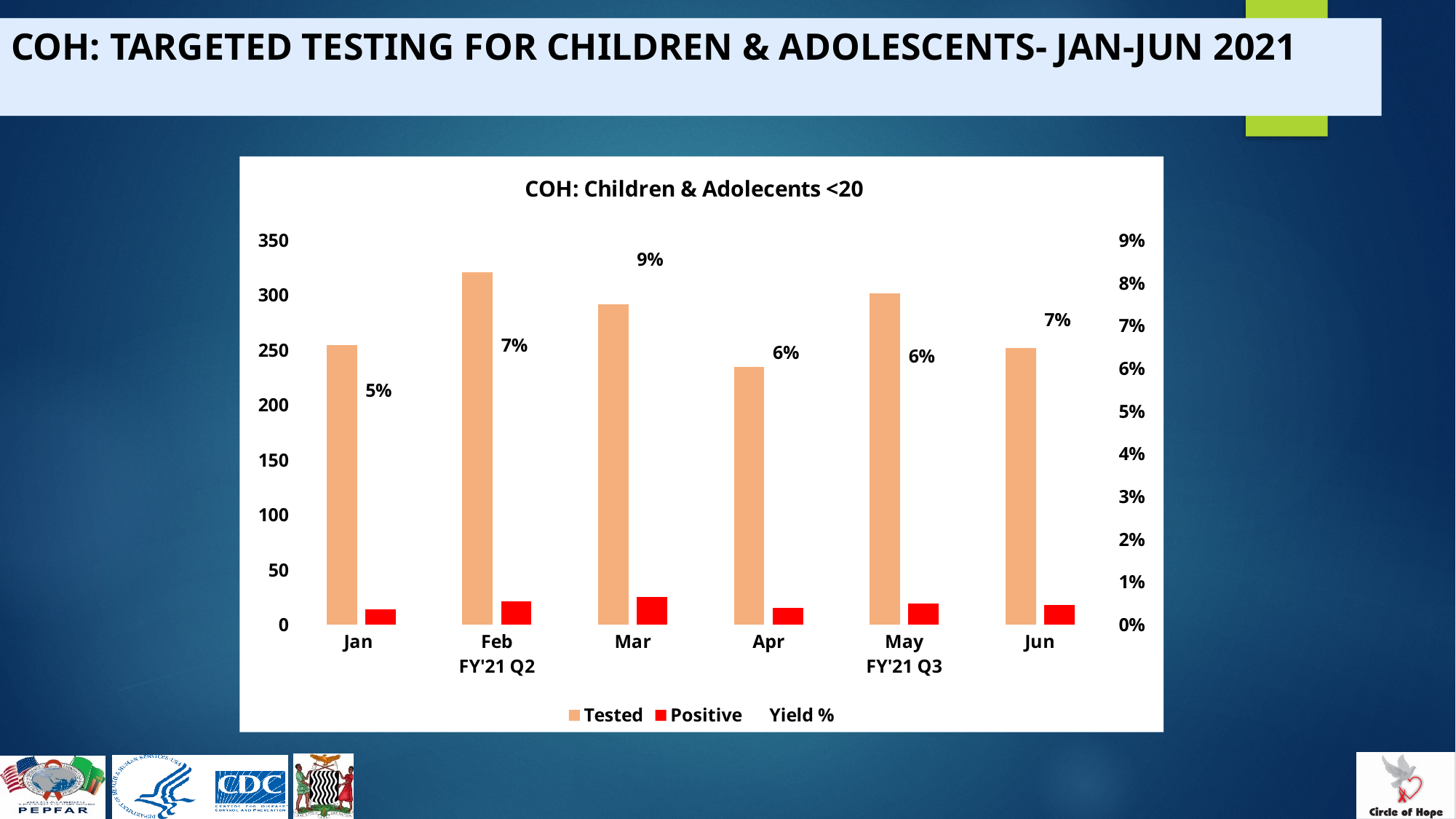
What is the difference between the Yield % for Mar and the Yield % for Jan? 4% Which month has the highest Yield %? Mar How many months are shown on the x axis of the chart? 6 What is the Yield % for Jun? 7% Which month has the lowest Yield %? Jan Which month has the tallest Tested bar? Feb What is the Yield % for Jan? 5% What is the Yield % for Mar in the COH: Children & Adolecents <20 chart? 9% Is the Tested value for Feb greater or less than 300? greater Is the Tested value for Apr greater or less than 250? less How many series does the chart legend list? 3 Which month has a higher Yield %, Feb or Apr? Feb